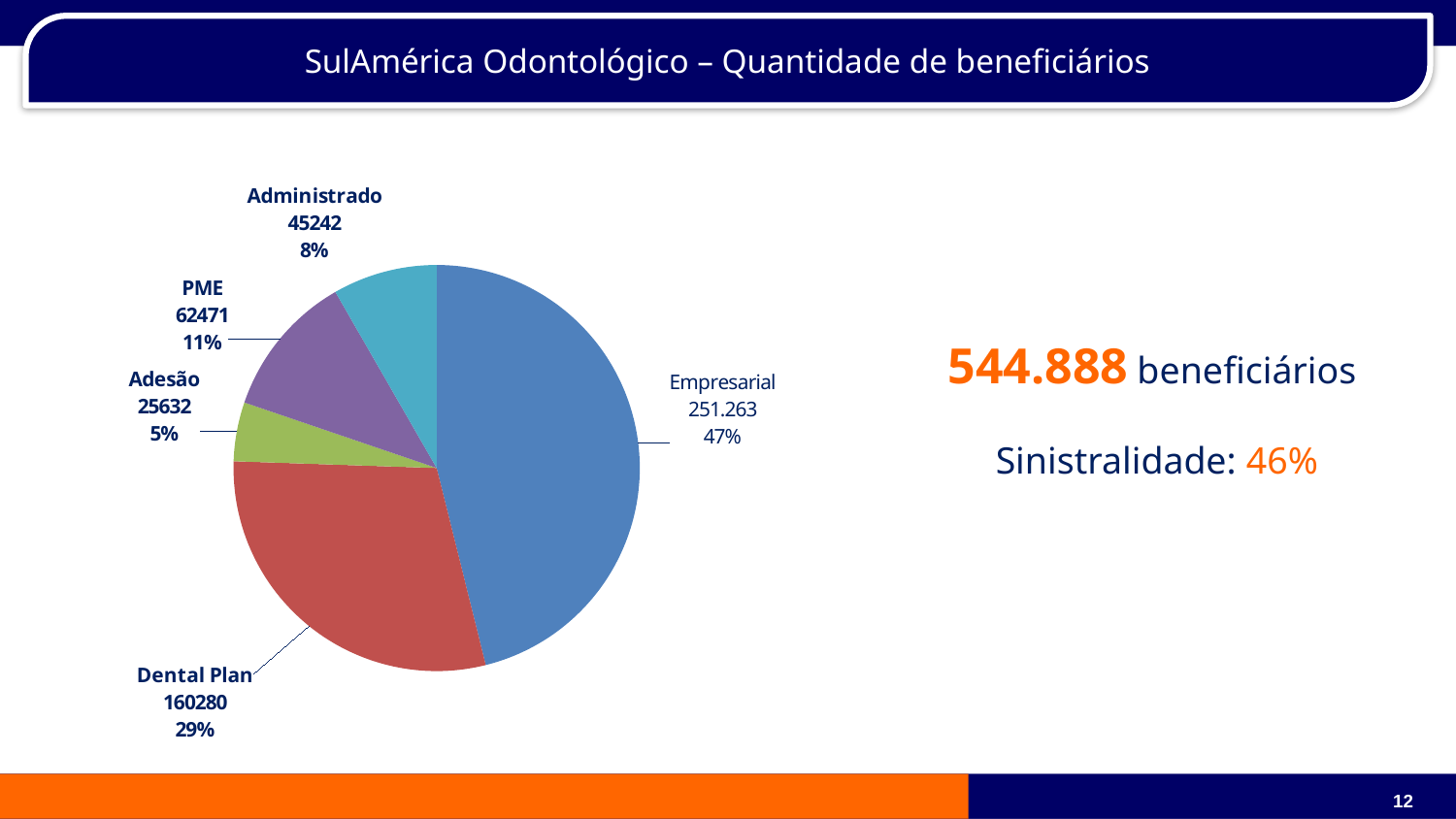
What share of the pie does Adesão represent? 5% What is the number of beneficiaries for Empresarial? 251.263 What share of the pie does Dental Plan represent? 29% Which category has the largest slice of the pie? Empresarial What is the difference in beneficiaries between PME and Administrado? 17229 What is the number of beneficiaries for Administrado? 45242 What is the number of beneficiaries for Dental Plan? 160280 Which has more beneficiaries, PME or Administrado? PME What is the number of beneficiaries for PME? 62471 What kind of chart is shown on the slide? pie chart Which category has the smallest slice of the pie? Adesão How many slices does the pie chart have? 5